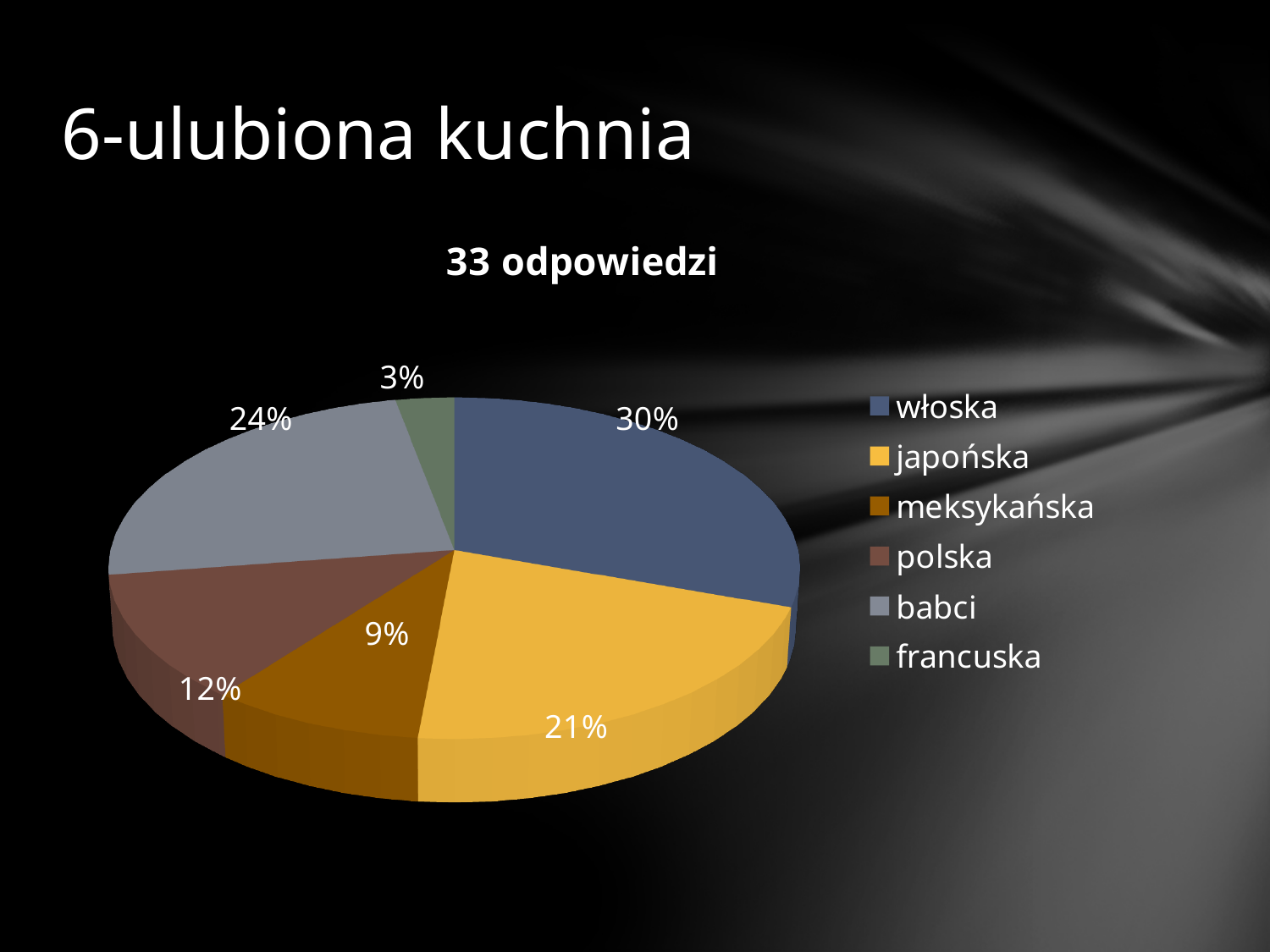
What share of the pie does meksykańska have? 9% What share of the pie does japońska have? 21% What is the difference in percentage points between włoska and polska? 18 What kind of chart is shown on the slide? pie chart Which category has the smallest slice? francuska What is the chart's title? 33 odpowiedzi What colour is the slice for japońska? yellow Which is larger, the slice for babci or the slice for japońska? babci Which category has the largest slice? włoska What share of the pie does włoska have? 30% How many categories does the legend list? 6